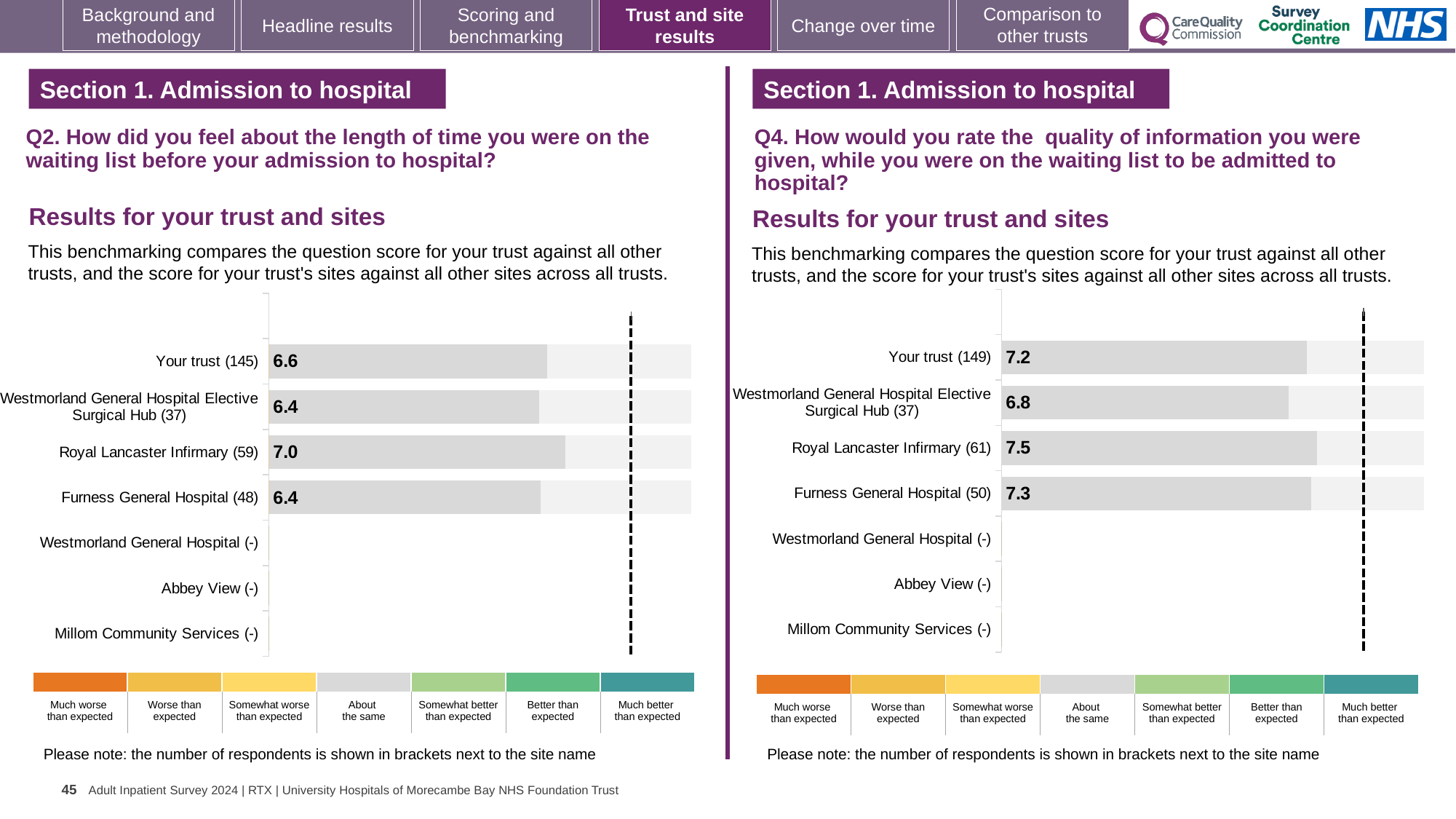
On the Q4 chart (right), what is the difference between the scores for Your trust and Westmorland General Hospital Elective Surgical Hub? 0.4 On the Q2 chart (left), what is the score for Royal Lancaster Infirmary? 7.0 What kind of chart is used on the Q2 chart (left)? bar chart On the Q4 chart (right), what is the score for Furness General Hospital? 7.3 On the Q4 chart (right), which site has the lowest score among those with a score shown? Westmorland General Hospital Elective Surgical Hub On the Q4 chart (right), is the score for Your trust larger or smaller than the score for Royal Lancaster Infirmary? smaller On the Q2 chart (left), what is the difference between the scores for Royal Lancaster Infirmary and Furness General Hospital? 0.6 On the Q4 chart (right), what is the score for Westmorland General Hospital Elective Surgical Hub? 6.8 On the Q2 chart (left), which site has the highest score? Royal Lancaster Infirmary On the Q4 chart (right), which site has the highest score? Royal Lancaster Infirmary On the Q2 chart (left), how many respondents are shown for Your trust? 145 On the Q2 chart (left), what is the score for Your trust? 6.6